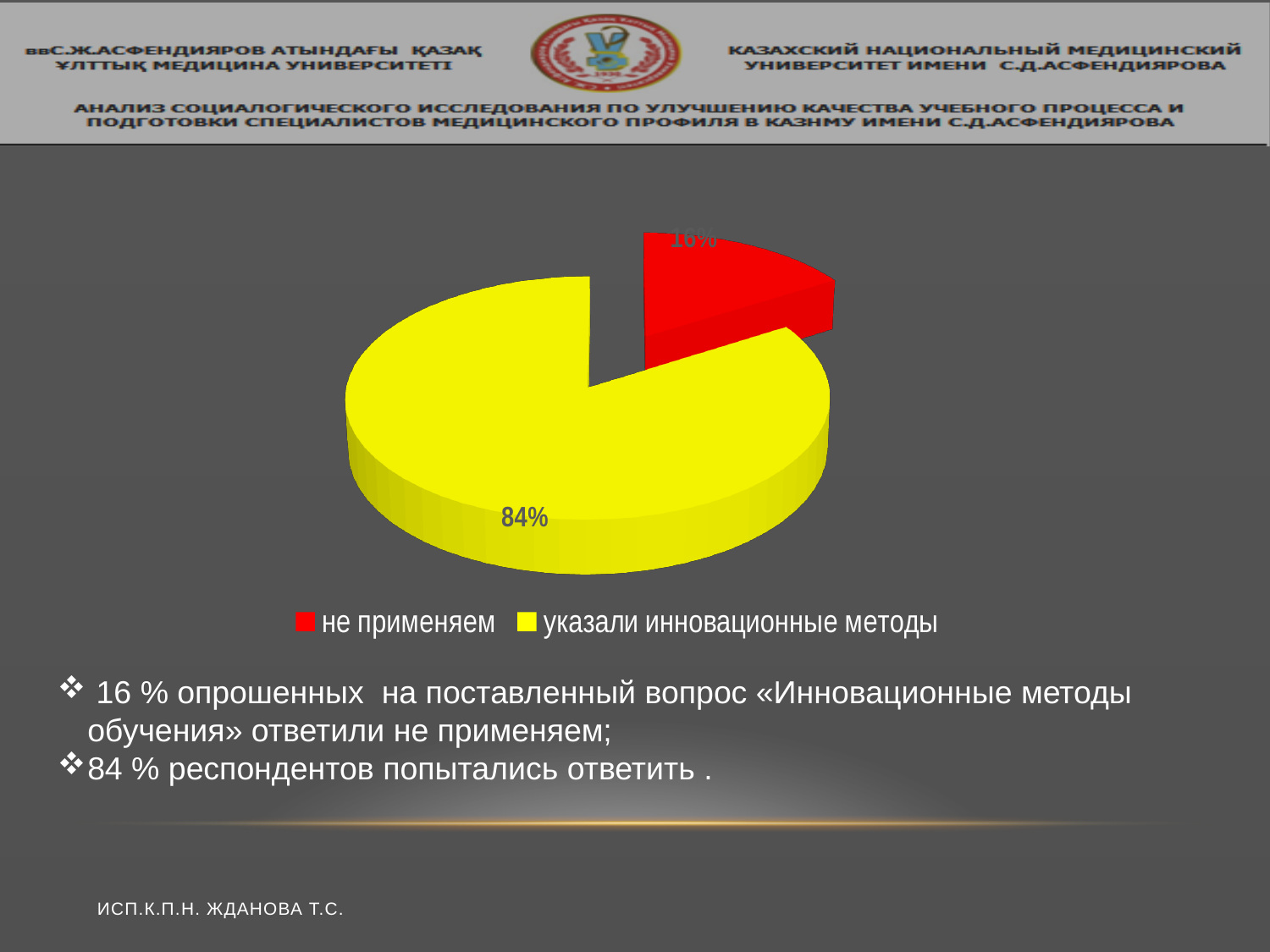
What kind of chart is shown on the slide? pie chart Which slice of the pie is the smallest? не применяем Which slice of the pie is the largest? указали инновационные методы What colour is the "не применяем" slice? red How many entries does the legend list? 2 Is the share of the "указали инновационные методы" slice greater or less than 50%? greater Which is larger: the "не применяем" slice or the "указали инновационные методы" slice? указали инновационные методы What share of the pie does the slice "не применяем" represent? 16% What is the difference in percentage points between the "указали инновационные методы" slice and the "не применяем" slice? 68 How many slices does the pie chart have? 2 What share of the pie does the slice "указали инновационные методы" represent? 84% What colour is the "указали инновационные методы" slice? yellow